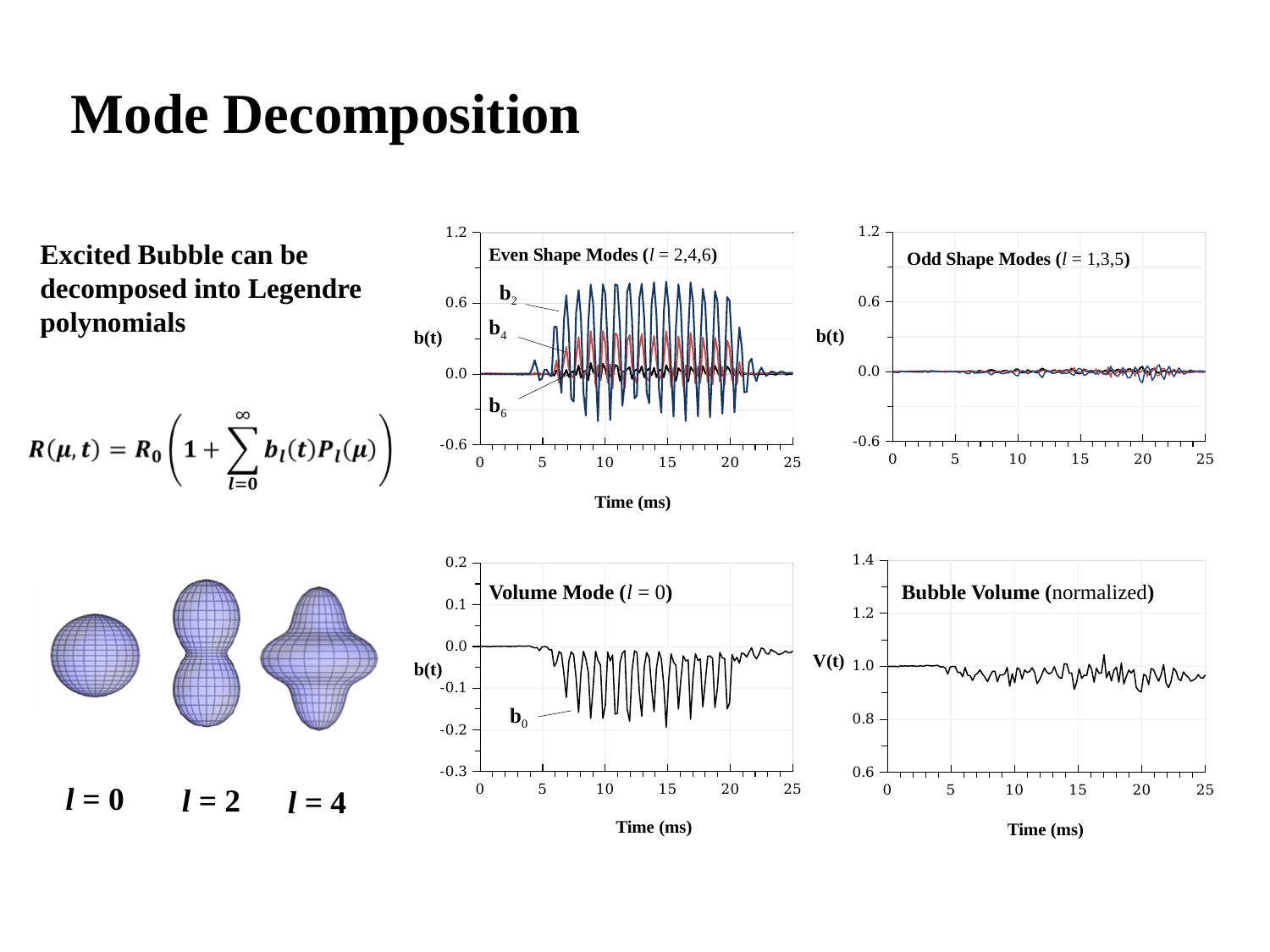
How many charts are shown on the slide? 4 In the 'Odd Shape Modes' chart, is the value of b(t) at time 10 ms greater or less than 0.6? less Which chart shows larger oscillation amplitudes, 'Even Shape Modes' or 'Odd Shape Modes'? Even Shape Modes In the 'Even Shape Modes' chart, is the peak value of b2 greater or less than 0.6? greater What kind of chart is the 'Even Shape Modes' chart? line chart In the 'Volume Mode' chart, is the value of b0 at time 0 greater or less than -0.1? greater How many tick labels are shown on the x-axis of the 'Even Shape Modes' chart? 6 Which series are labelled on the 'Even Shape Modes' chart? b2, b4, b6 What is the y-axis label of the 'Bubble Volume (normalized)' chart? V(t)